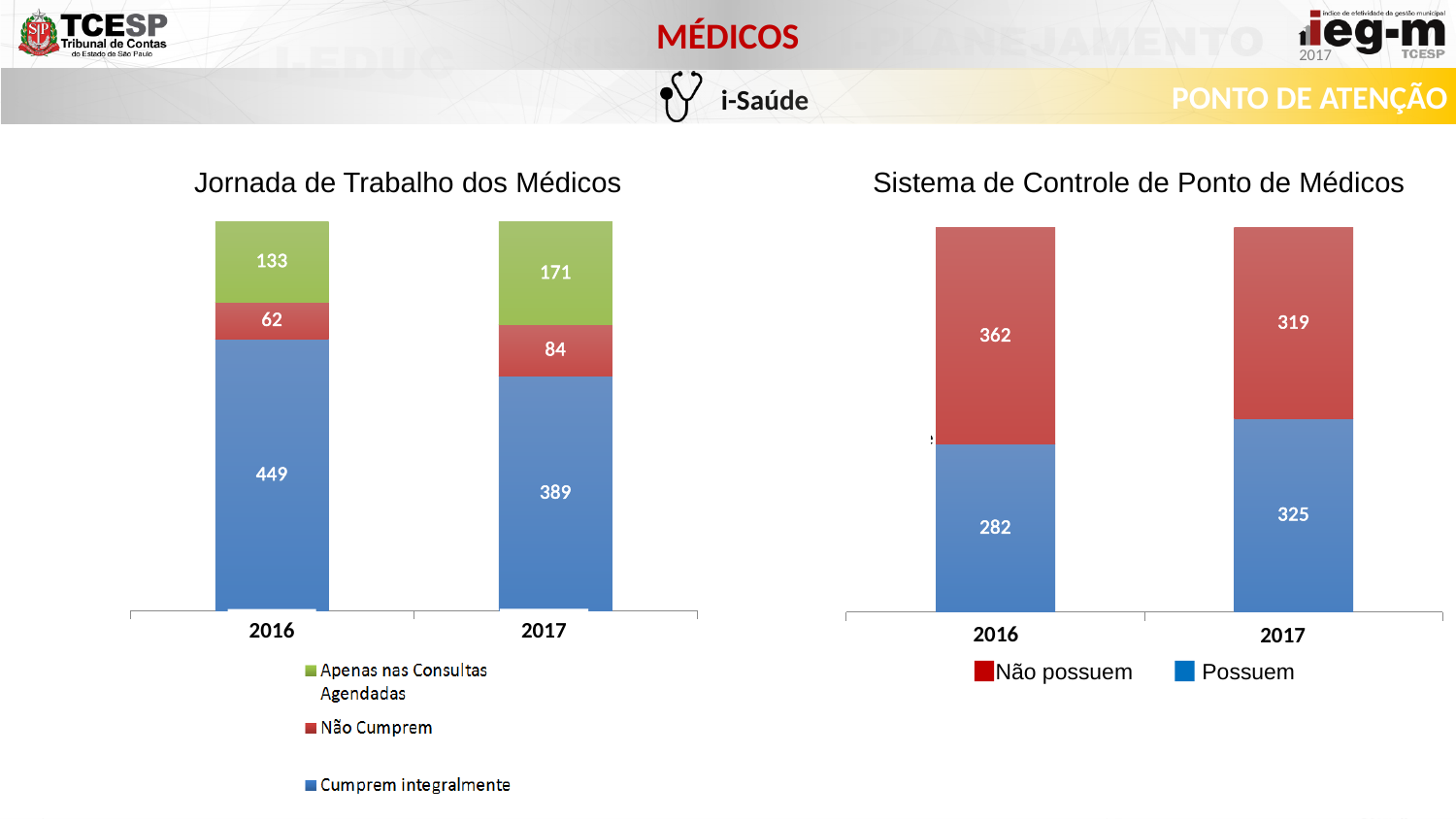
In the chart 'Jornada de Trabalho dos Médicos', what is the value for 'Apenas nas Consultas Agendadas' in 2017? 171 What kind of chart is 'Sistema de Controle de Ponto de Médicos'? stacked bar chart In the chart 'Sistema de Controle de Ponto de Médicos', what is the total of the stacked bar for 2016? 644 In the chart 'Jornada de Trabalho dos Médicos', how many series does the legend list? 3 In the chart 'Jornada de Trabalho dos Médicos', what is the difference between the 'Cumprem integralmente' values for 2016 and 2017? 60 In the chart 'Jornada de Trabalho dos Médicos', does the 'Não Cumprem' value rise or fall from 2016 to 2017? rise In the chart 'Sistema de Controle de Ponto de Médicos', which is larger in 2016: 'Possuem' or 'Não possuem'? Não possuem In the chart 'Jornada de Trabalho dos Médicos', what is the value for 'Não Cumprem' in 2016? 62 In the chart 'Sistema de Controle de Ponto de Médicos', what is the value for 'Não possuem' in 2016? 362 In the chart 'Sistema de Controle de Ponto de Médicos', what is the value for 'Possuem' in 2017? 325 In the chart 'Jornada de Trabalho dos Médicos', what is the value for 'Cumprem integralmente' in 2016? 449 In the chart 'Jornada de Trabalho dos Médicos', what is the total of the stacked bar for 2017? 644